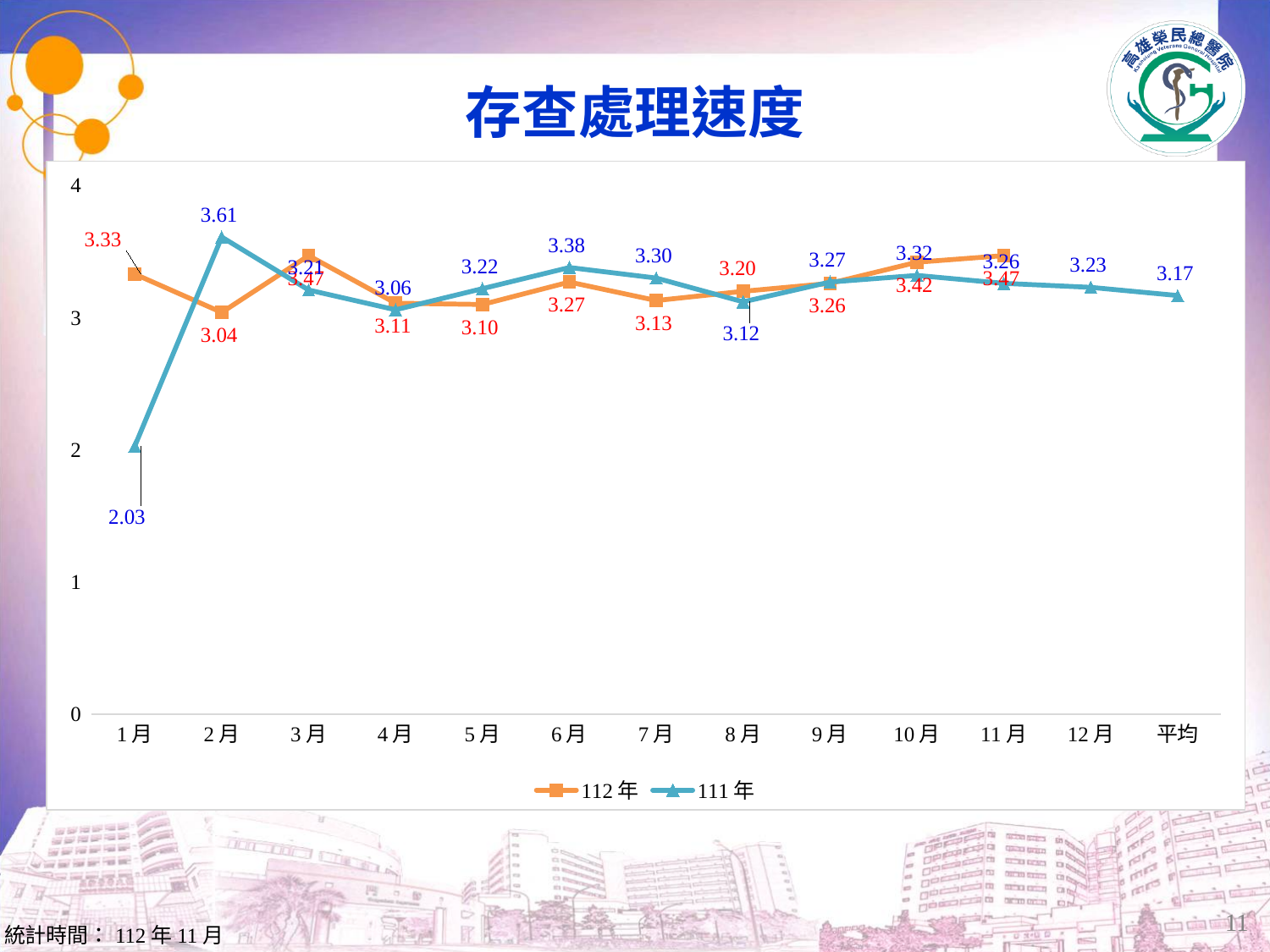
In which month is the 111年 value lowest? 1月 In 2月, which series has the larger value, 112年 or 111年? 111年 What is the value for 112年 in 10月? 3.42 What is the difference between the 112年 and 111年 values in 1月? 1.30 What is the value for 112年 in 1月? 3.33 What kind of chart is shown on the slide? line chart What is the value for 111年 in 2月? 3.61 How many series does the legend list? 2 What is the value for 111年 in 1月? 2.03 In which month is the 111年 value highest? 2月 What is the value for 111年 at 平均? 3.17 How many categories are shown along the x axis? 13